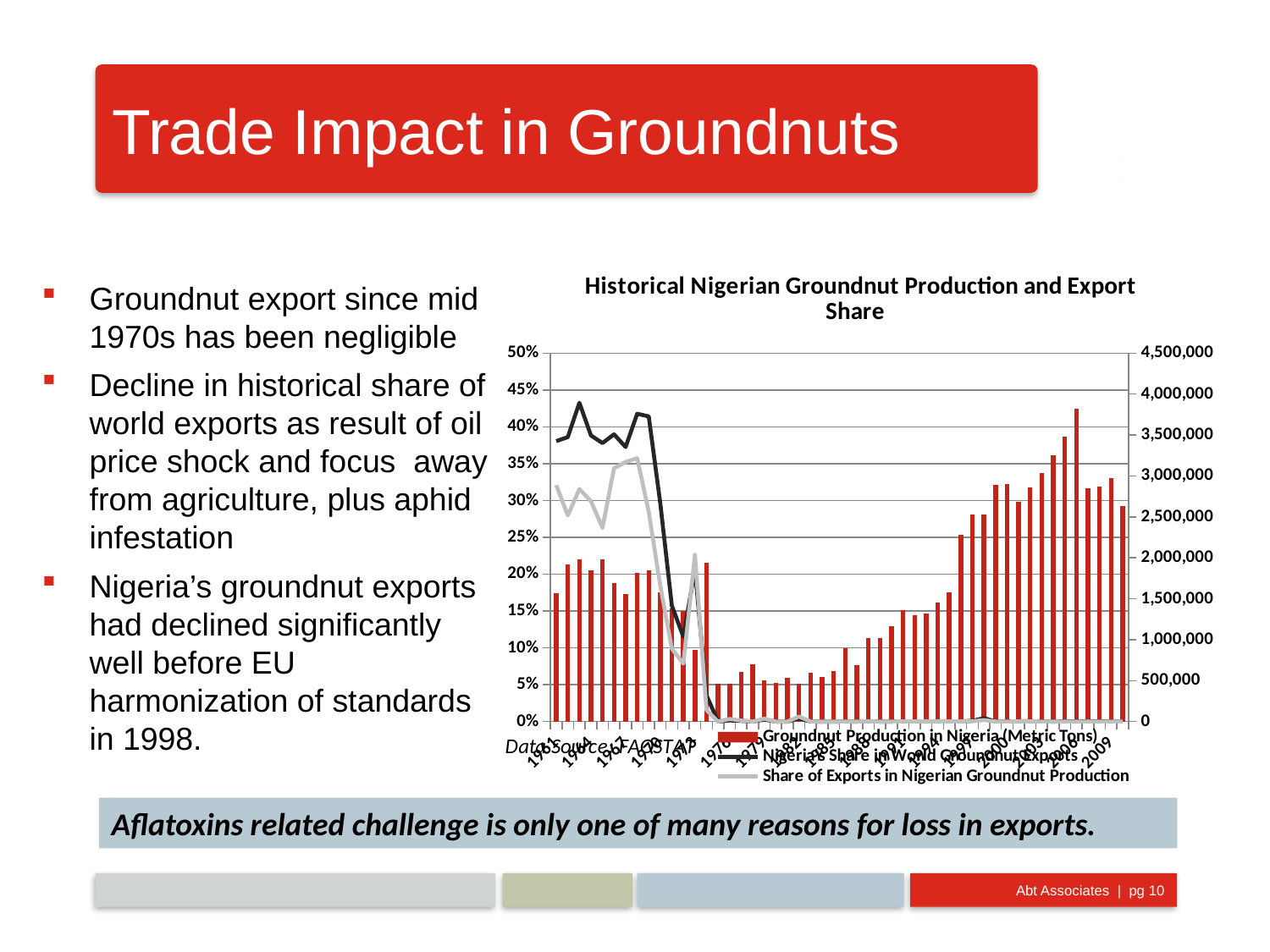
Is Nigeria's Share in World Groundnut Exports at the start of the series (early 1960s) greater or less than 35%? greater Is the tallest Groundnut Production in Nigeria bar greater or less than 3,500,000 metric tons? greater How many series does the chart's legend list? 3 Does Nigeria's Share in World Groundnut Exports rise or fall from the early 1960s to the late 1970s? fall Which series reaches the highest percentage value on the left axis? Nigeria's Share in World Groundnut Exports What kind of chart is used to show Groundnut Production in Nigeria (Metric Tons)? Bar chart Is Nigeria's Share in World Groundnut Exports in 2009 greater or less than 5%? less Do the Groundnut Production in Nigeria bars rise or fall from the mid-1980s to the mid-2000s? rise What is the title of the chart on the slide? Historical Nigerian Groundnut Production and Export Share Which series in the chart is drawn as red bars? Groundnut Production in Nigeria (Metric Tons) What is the maximum value shown on the right-hand axis of the chart? 4,500,000